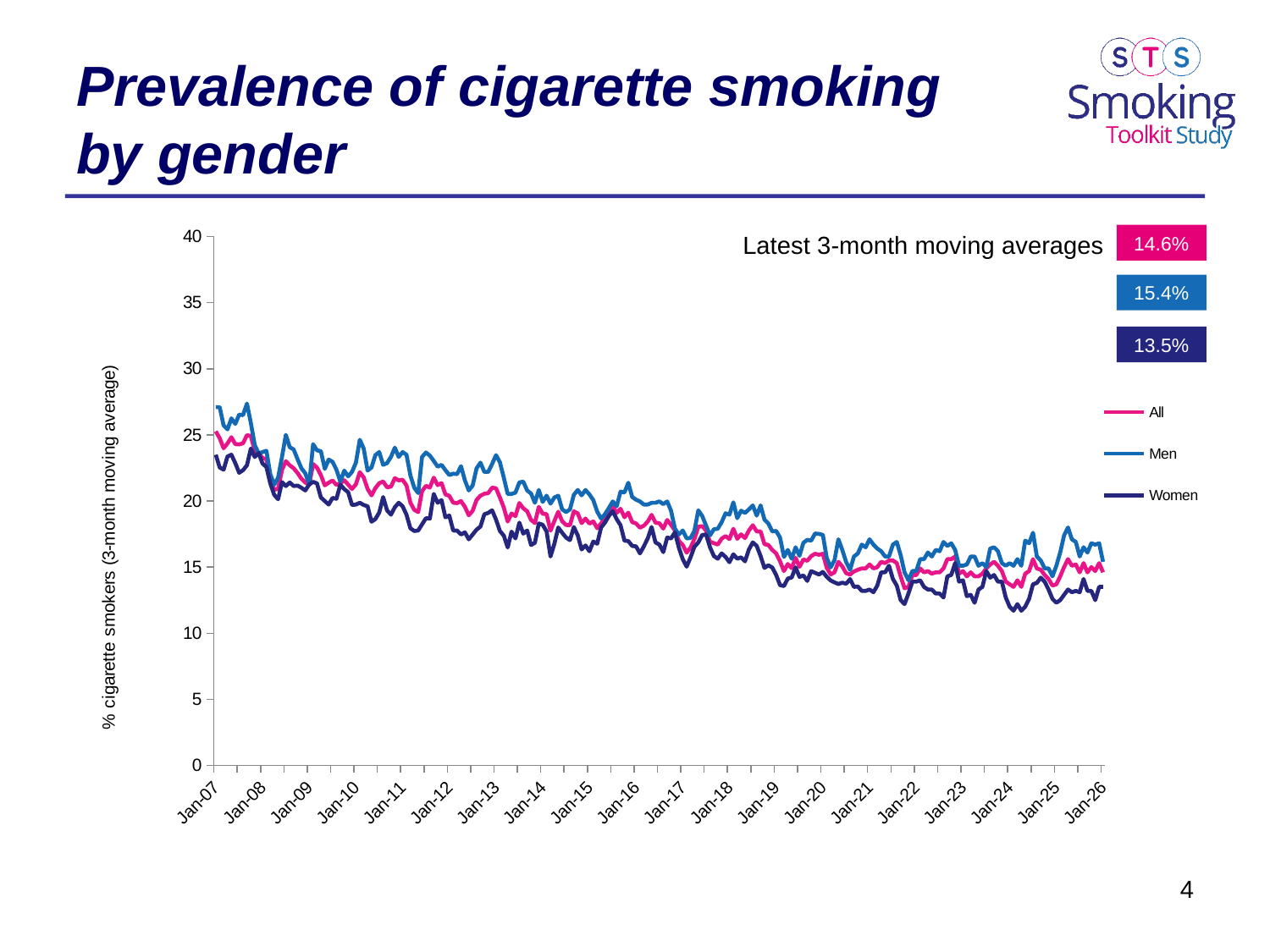
Do the smoking prevalence values rise or fall from Jan-07 to Jan-26? Fall What is the latest 3-month moving average for All smokers? 14.6% Which group has the highest latest 3-month moving average? Men What kind of chart is shown on the slide? Line chart How many series does the legend list? 3 Is the latest 3-month moving average higher for Men or for All? Men Which group has the lowest latest 3-month moving average? Women What is the latest 3-month moving average for Men? 15.4% Is the value for Women at Jan-26 greater or less than 15? less What is the latest 3-month moving average for Women? 13.5% Is the value for Men at Jan-07 greater or less than 25? greater What is the difference between the latest 3-month moving averages for Men and Women? 1.9 percentage points